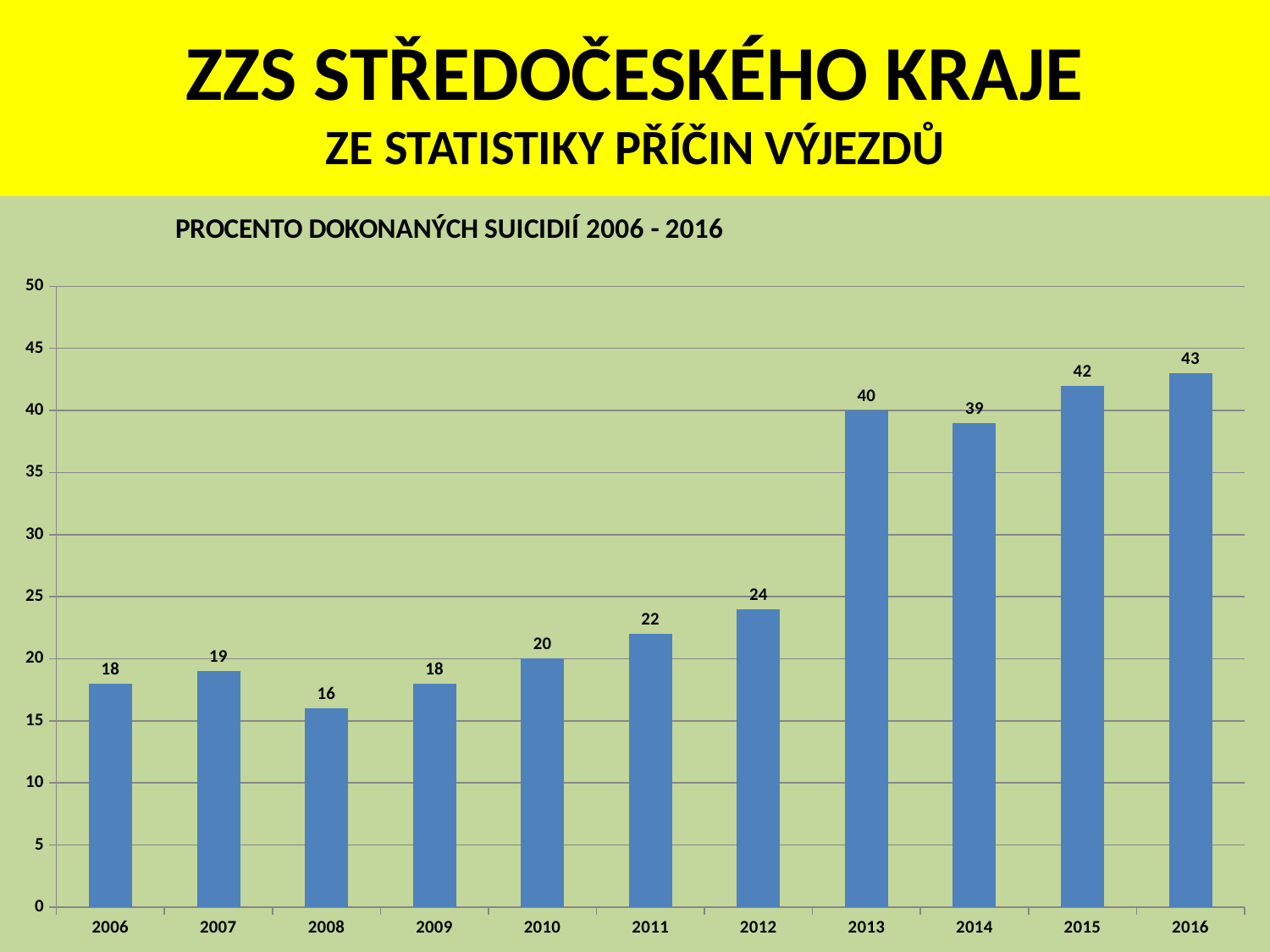
What kind of chart is shown on the slide? bar chart What is the value for 2008? 16 What is the difference between the values for 2013 and 2012? 16 What is the title of the chart? PROCENTO DOKONANÝCH SUICIDIÍ 2006 - 2016 Which year has the lowest value? 2008 What is the difference between the values for 2016 and 2006? 25 What is the value for 2013? 40 Is the value for 2012 greater or less than 30? less How many years are shown on the x axis? 11 Which year has the highest value? 2016 Which is larger, the value for 2014 or the value for 2015? 2015 What is the value for 2011? 22